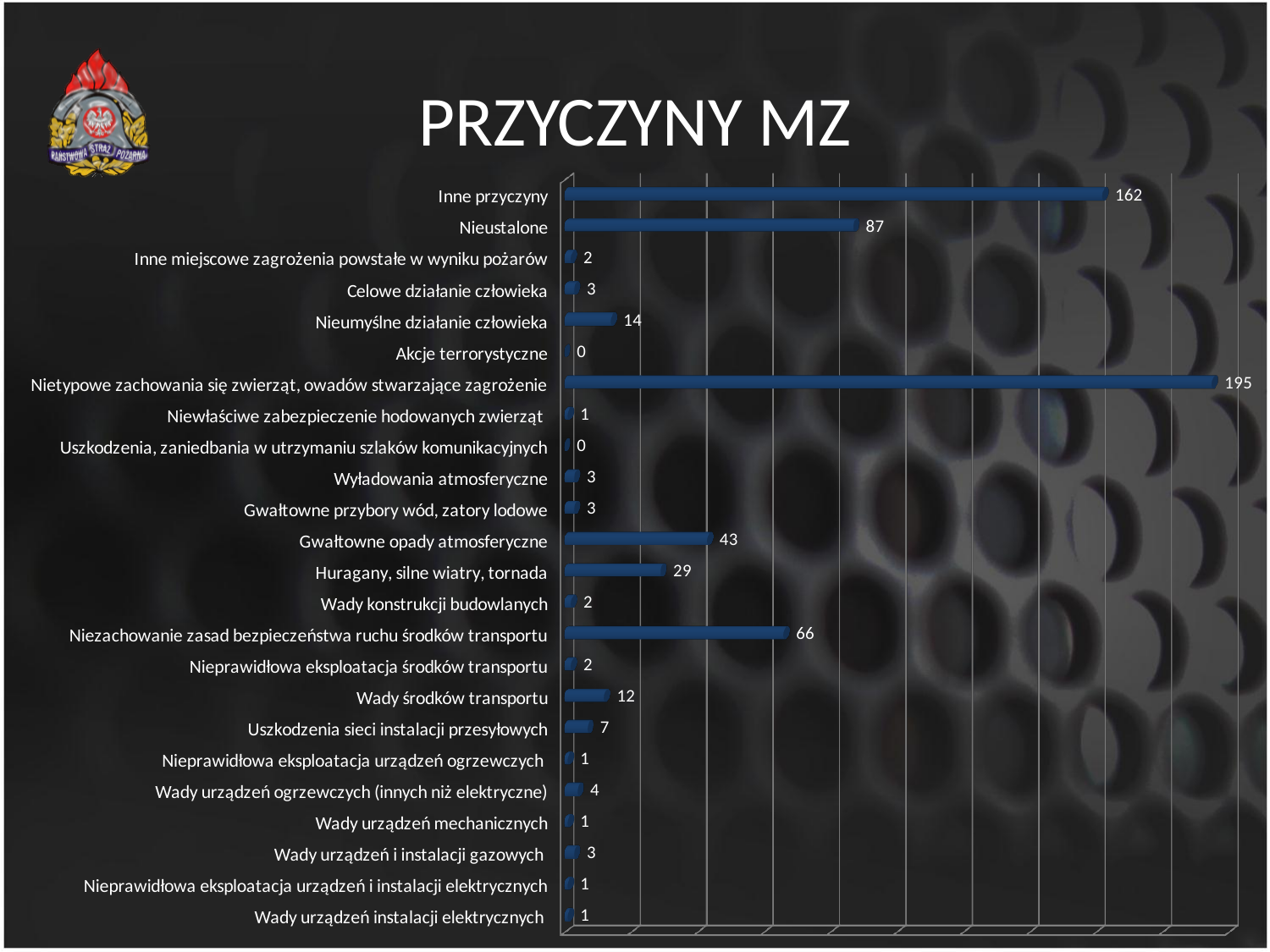
What is the difference between the values for Gwałtowne opady atmosferyczne and Huragany, silne wiatry, tornada? 14 What is the value for Niezachowanie zasad bezpieczeństwa ruchu środków transportu? 66 Which is larger, the value for Wady środków transportu or the value for Nieumyślne działanie człowieka? Nieumyślne działanie człowieka What is the value for Gwałtowne opady atmosferyczne? 43 What is the title of the slide? PRZYCZYNY MZ What is the value for Nietypowe zachowania się zwierząt, owadów stwarzające zagrożenie? 195 What is the difference between the values for Inne przyczyny and Nieustalone? 75 What kind of chart is shown on the slide? Bar chart Which category has the highest value? Nietypowe zachowania się zwierząt, owadów stwarzające zagrożenie How many categories are shown in the chart? 24 What is the value for Inne przyczyny? 162 Which is larger, the value for Nieustalone or the value for Niezachowanie zasad bezpieczeństwa ruchu środków transportu? Nieustalone